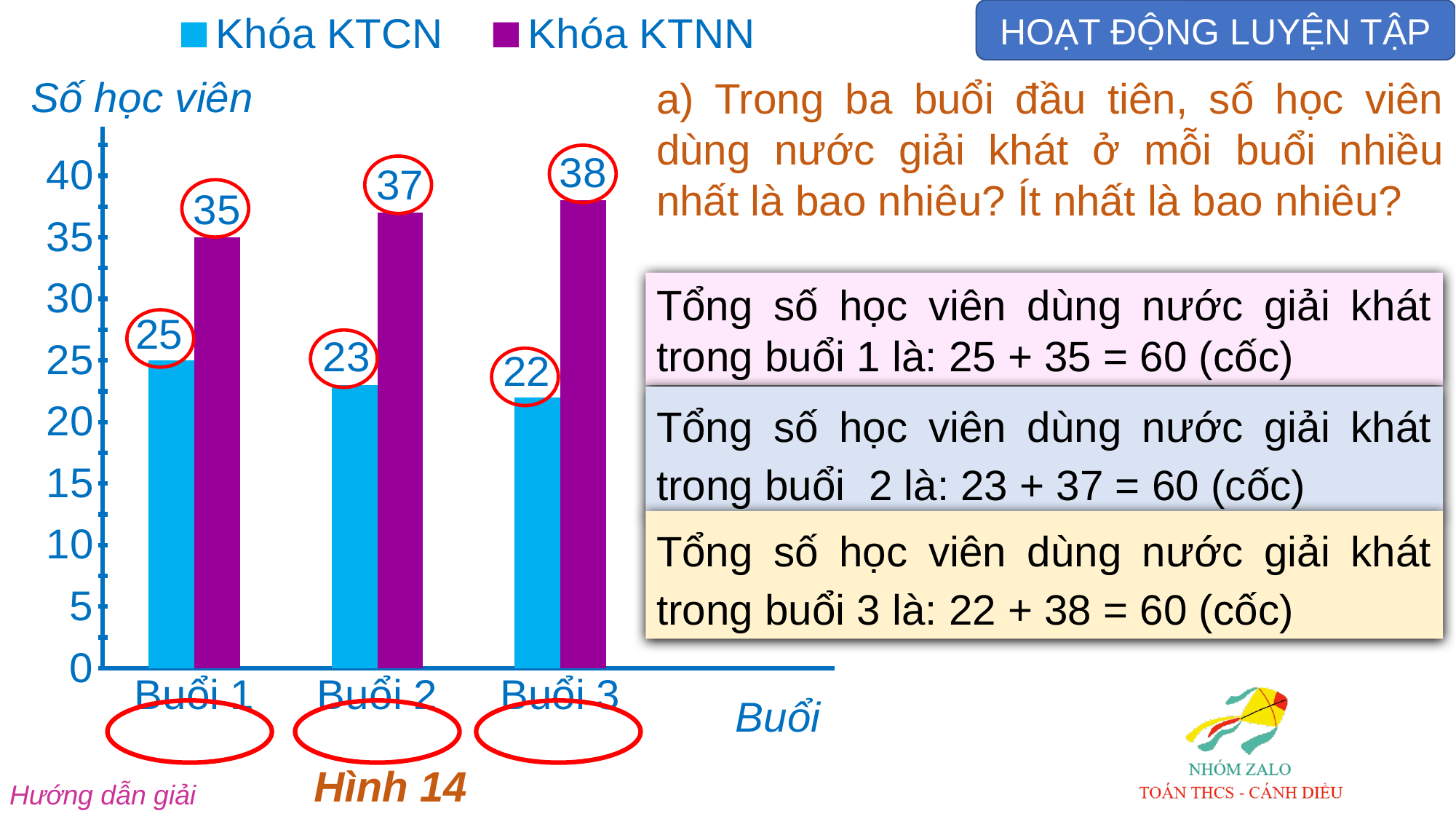
What is the difference between Khóa KTNN and Khóa KTCN in Buổi 1? 10 Is the value for Khóa KTCN in Buổi 3 greater or less than 25? less What is the value for Khóa KTNN in Buổi 3? 38 Which session (Buổi) has the lowest value for Khóa KTCN? Buổi 3 What is the value for Khóa KTCN in Buổi 1? 25 What kind of chart is shown? bar chart How many sessions (Buổi) are shown on the x axis? 3 Which session (Buổi) has the highest value for Khóa KTNN? Buổi 3 Which is larger in Buổi 2: Khóa KTCN or Khóa KTNN? Khóa KTNN Do the values for Khóa KTCN rise or fall from Buổi 1 to Buổi 3? fall How many series does the legend list? 2 What is the value for Khóa KTNN in Buổi 2? 37